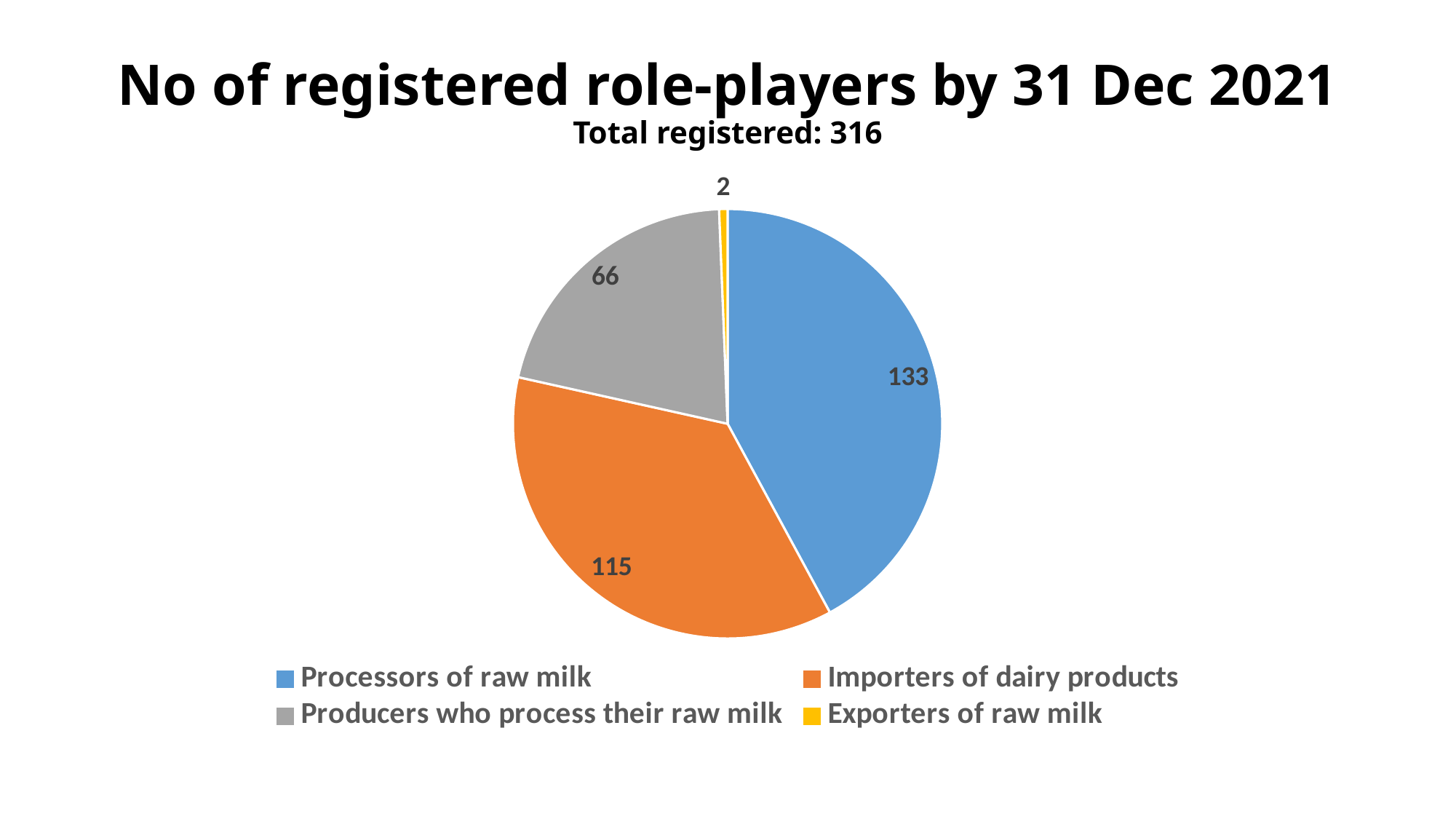
What is the value for Exporters of raw milk? 2 What is the difference between Importers of dairy products and Producers who process their raw milk? 49 What is the value for Importers of dairy products? 115 What is the value for Processors of raw milk? 133 What kind of chart is shown on the slide? Pie chart Which is larger, Producers who process their raw milk or Importers of dairy products? Importers of dairy products What is the difference between Processors of raw milk and Importers of dairy products? 18 Which category has the largest slice? Processors of raw milk How many categories does the pie chart show? 4 Which category has the smallest slice? Exporters of raw milk What is the value for Producers who process their raw milk? 66 What is the total number of registered role-players shown on the slide? 316